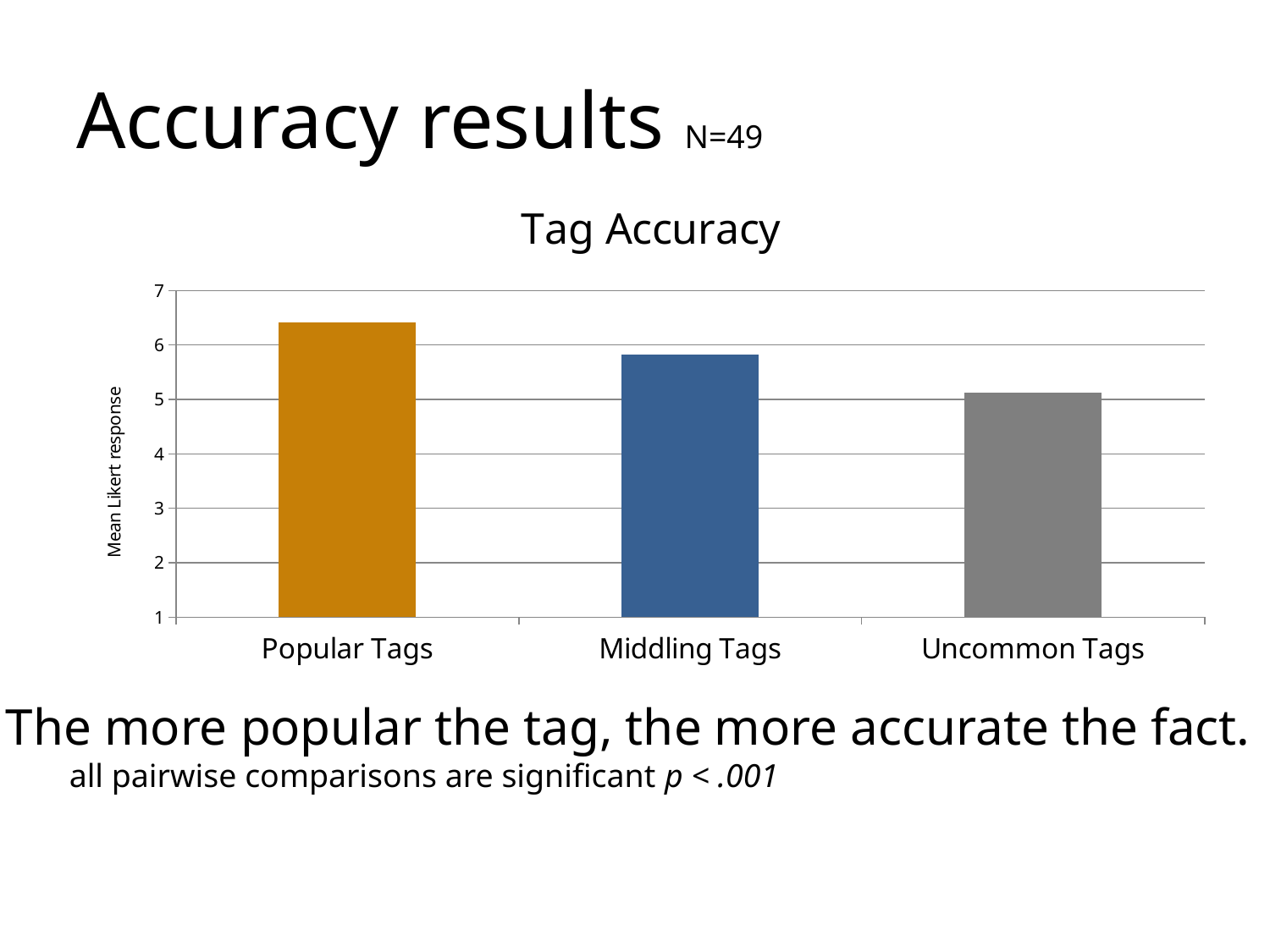
Is the value for Uncommon Tags greater or less than 6? less Is the value for Middling Tags greater or less than 6? less Do the values rise or fall moving from Popular Tags to Uncommon Tags along the x axis? fall What is the label on the vertical axis of the chart? Mean Likert response Which category has the lowest mean Likert response? Uncommon Tags Is the value for Popular Tags greater or less than 6? greater What type of chart is shown on the slide? bar chart Which category has the highest mean Likert response? Popular Tags How many categories are shown on the x axis of the chart? 3 Which has a higher mean Likert response, Popular Tags or Middling Tags? Popular Tags Which has a higher mean Likert response, Middling Tags or Uncommon Tags? Middling Tags What is the title of the chart? Tag Accuracy